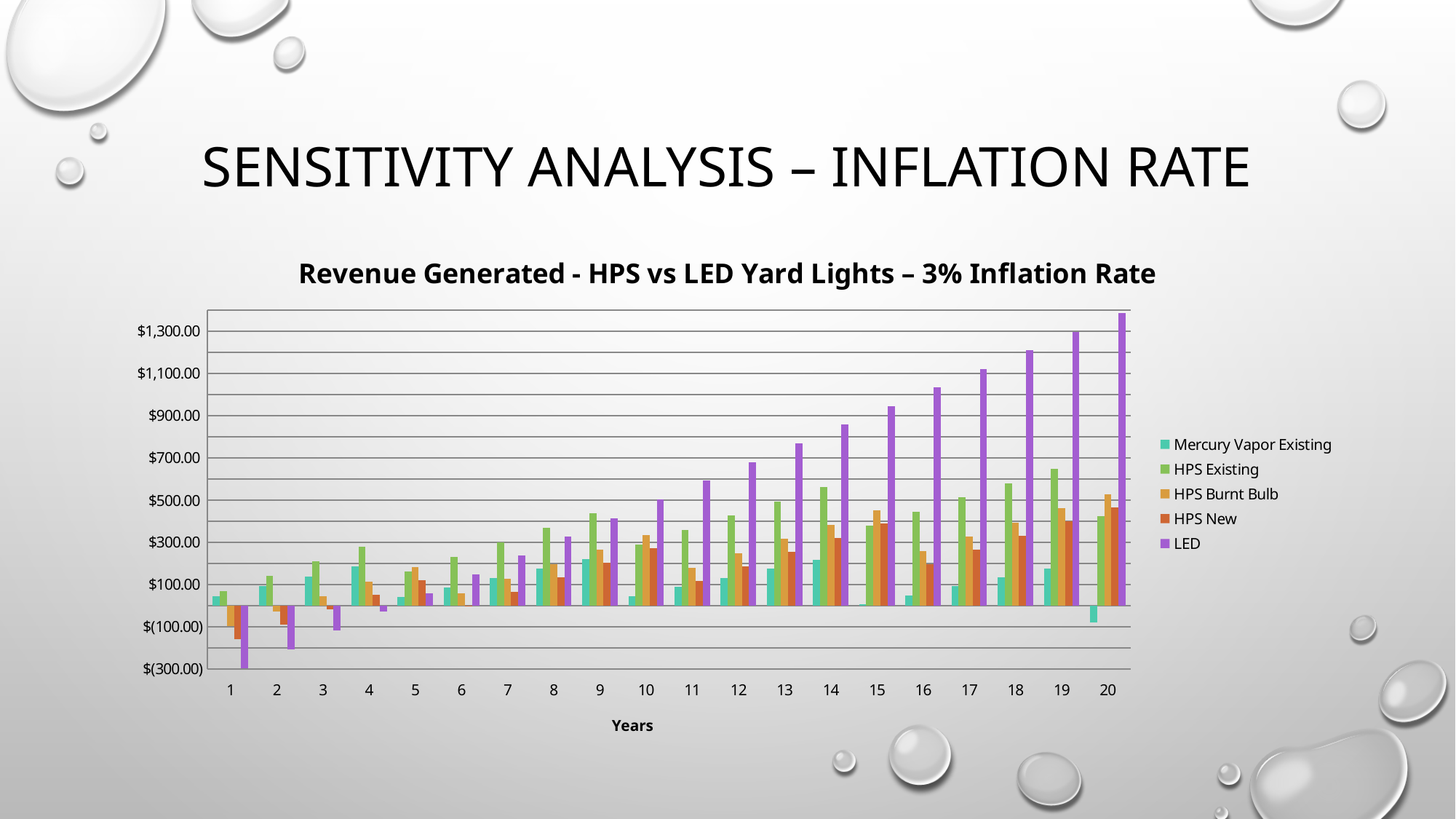
Which series has the lowest value in year 1? LED How many series does the legend list? 5 What is the title of the chart? Revenue Generated - HPS vs LED Yard Lights – 3% Inflation Rate Is the HPS Existing value in year 19 greater or less than $500.00? greater What kind of chart is shown on the slide? Bar chart Is the LED value in year 1 greater or less than $(100.00)? less In year 4, which is larger: HPS Existing or Mercury Vapor Existing? HPS Existing Is the LED value in year 20 greater or less than $1,300.00? greater Which series has the tallest bar in year 20? LED What is the label of the x axis? Years How many years are shown along the x axis? 20